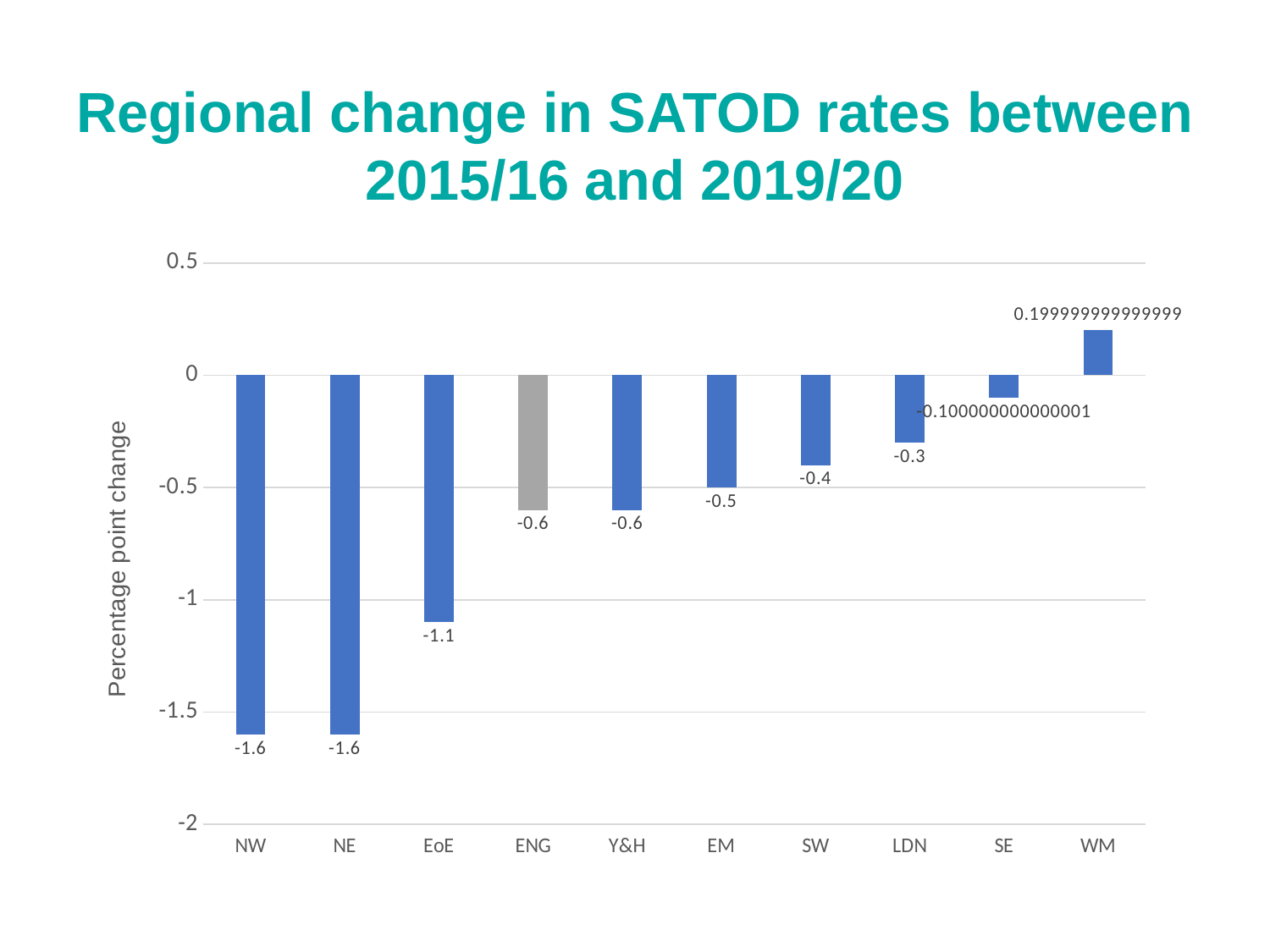
Which is larger, the value for EoE or the value for SW? SW Which category's bar is coloured grey rather than blue? ENG What is the value for EoE? -1.1 What is the difference between the values for EM and EoE? 0.6 What is the value for SW? -0.4 Which category has the highest value? WM Which two categories share the lowest value? NW and NE What is the value for ENG? -0.6 Is the value for SE greater or less than -0.5? greater What is the value for LDN? -0.3 What kind of chart is this? bar chart How many categories are shown on the x axis? 10